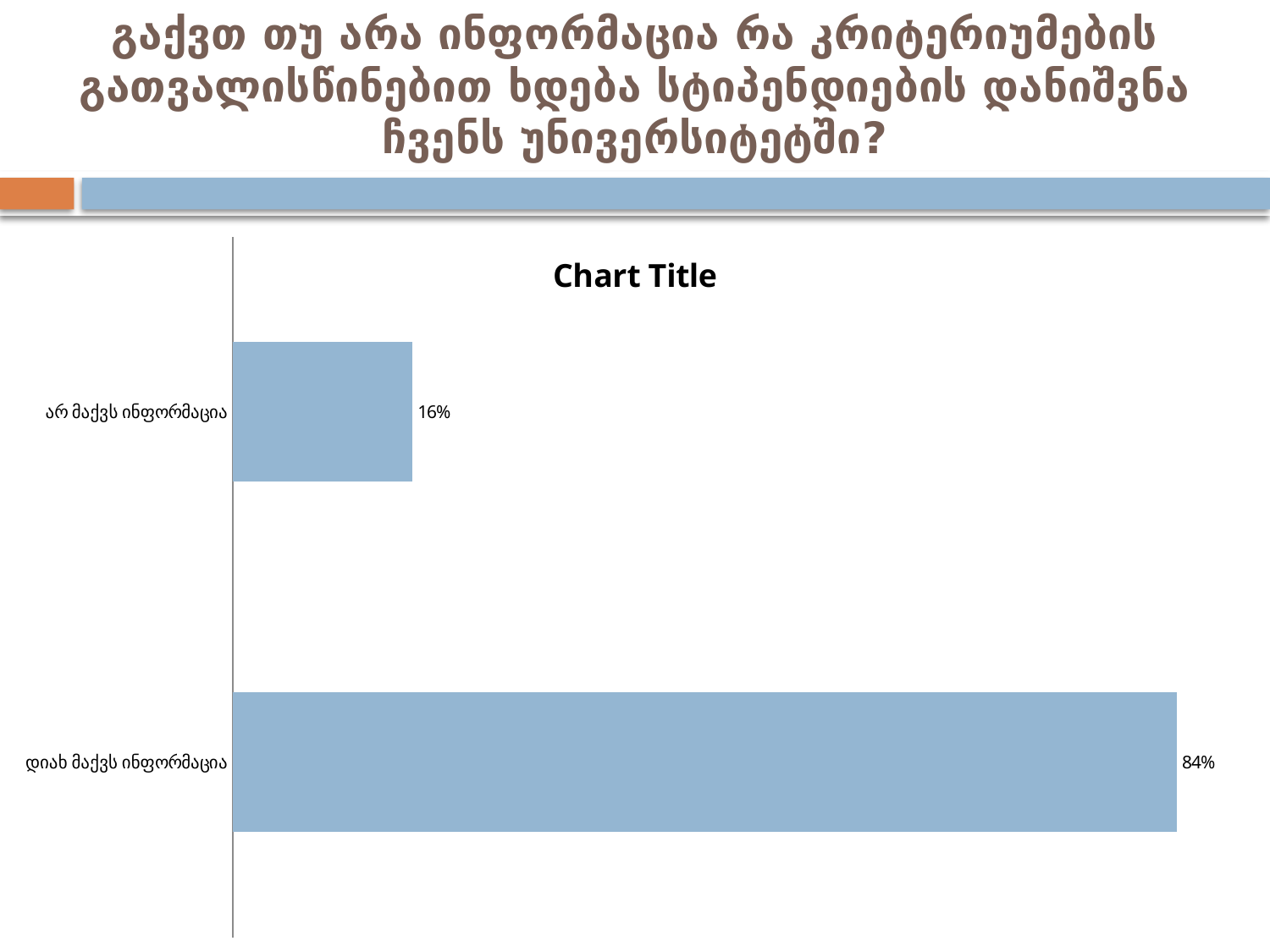
How many categories are shown in the chart? 2 Which is larger: the value for "დიახ მაქვს ინფორმაცია" or the value for "არ მაქვს ინფორმაცია"? დიახ მაქვს ინფორმაცია Which category has the highest value? დიახ მაქვს ინფორმაცია What is the value for "არ მაქვს ინფორმაცია"? 16% What is the value for "დიახ მაქვს ინფორმაცია"? 84% What is the difference between the values for "დიახ მაქვს ინფორმაცია" and "არ მაქვს ინფორმაცია"? 68% What kind of chart is shown on the slide? bar chart Which category has the lowest value? არ მაქვს ინფორმაცია What colour are the bars in the chart? light blue What is the title shown above the chart? Chart Title